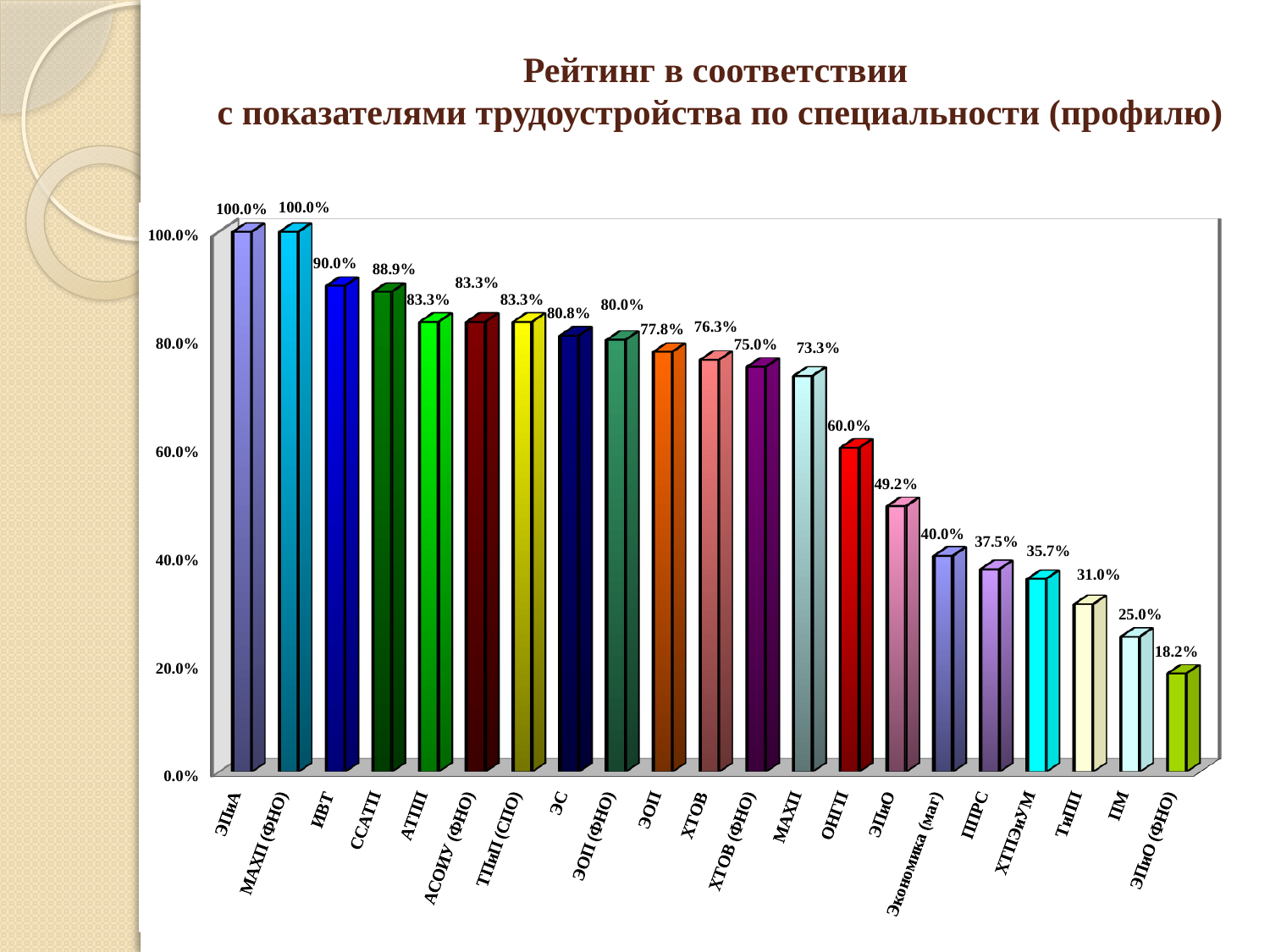
Do the values rise or fall from left to right along the x axis? fall What is the value for ИВТ? 90.0% What is the value for ПМ? 25.0% How many categories are shown on the x axis? 21 What is the value for ОНГП? 60.0% What is the value for Экономика (маг)? 40.0% What is the difference between the values for ОНГП and ЭПиО? 10.8% What kind of chart is shown on the slide? bar chart Is the value for ОНГП greater or less than 80.0%? less What is the difference between the values for ИВТ and ССАТП? 1.1% Which category has the lowest value? ЭПиО (ФНО) Which is larger, the value for ЭПиО or the value for Экономика (маг)? ЭПиО